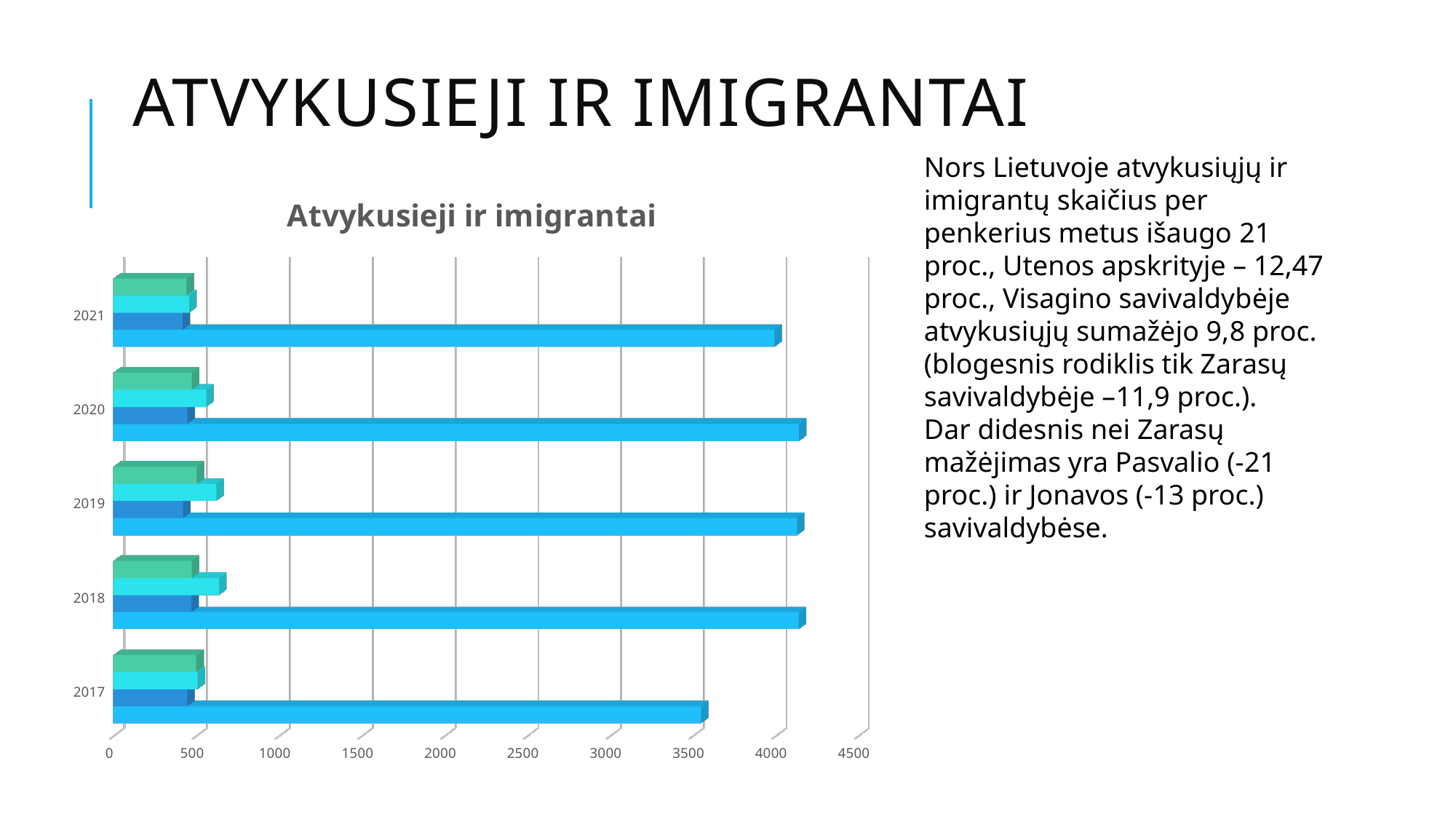
Is the value of the green (top) bar for 2021 greater or less than 500? less Which year has the larger longest (light blue) bar, 2017 or 2018? 2018 Is the value of the longest (light blue) bar for 2017 greater or less than 4000? less Is the value of the longest (light blue) bar for 2020 greater or less than 4000? greater How many bars are plotted for each year on the chart? 4 Which year has the larger longest (light blue) bar, 2021 or 2017? 2021 What is the title of the chart? Atvykusieji ir imigrantai Which year has the shortest longest (light blue) bar? 2017 How many years (categories) are shown on the chart's vertical axis? 5 What kind of chart is shown on the slide? bar chart